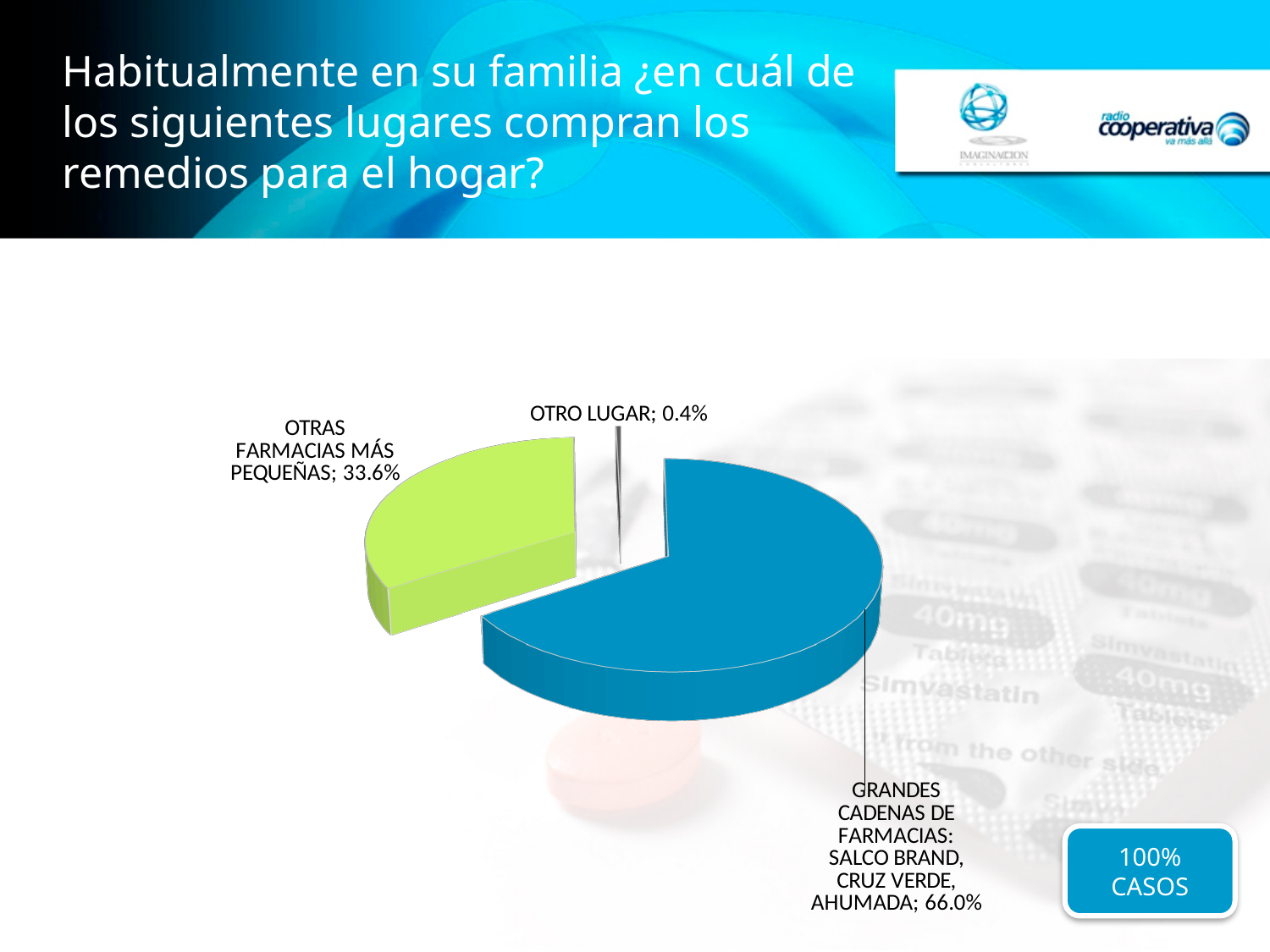
What is the difference in percentage points between GRANDES CADENAS DE FARMACIAS and OTRAS FARMACIAS MÁS PEQUEÑAS? 32.4 What colour is the slice for OTRAS FARMACIAS MÁS PEQUEÑAS? green What text appears in the box at the bottom right of the slide? 100% CASOS What share of the pie is labelled GRANDES CADENAS DE FARMACIAS: SALCO BRAND, CRUZ VERDE, AHUMADA? 66.0% What is the difference in percentage points between OTRAS FARMACIAS MÁS PEQUEÑAS and OTRO LUGAR? 33.2 Which category has the largest slice of the pie? GRANDES CADENAS DE FARMACIAS: SALCO BRAND, CRUZ VERDE, AHUMADA What share of the pie is labelled OTRO LUGAR? 0.4% How many slices does the pie chart have? 3 Which category has the smallest slice of the pie? OTRO LUGAR What kind of chart is shown on the slide? pie chart What share of the pie is labelled OTRAS FARMACIAS MÁS PEQUEÑAS? 33.6% Which is larger, the share for OTRAS FARMACIAS MÁS PEQUEÑAS or the share for OTRO LUGAR? OTRAS FARMACIAS MÁS PEQUEÑAS